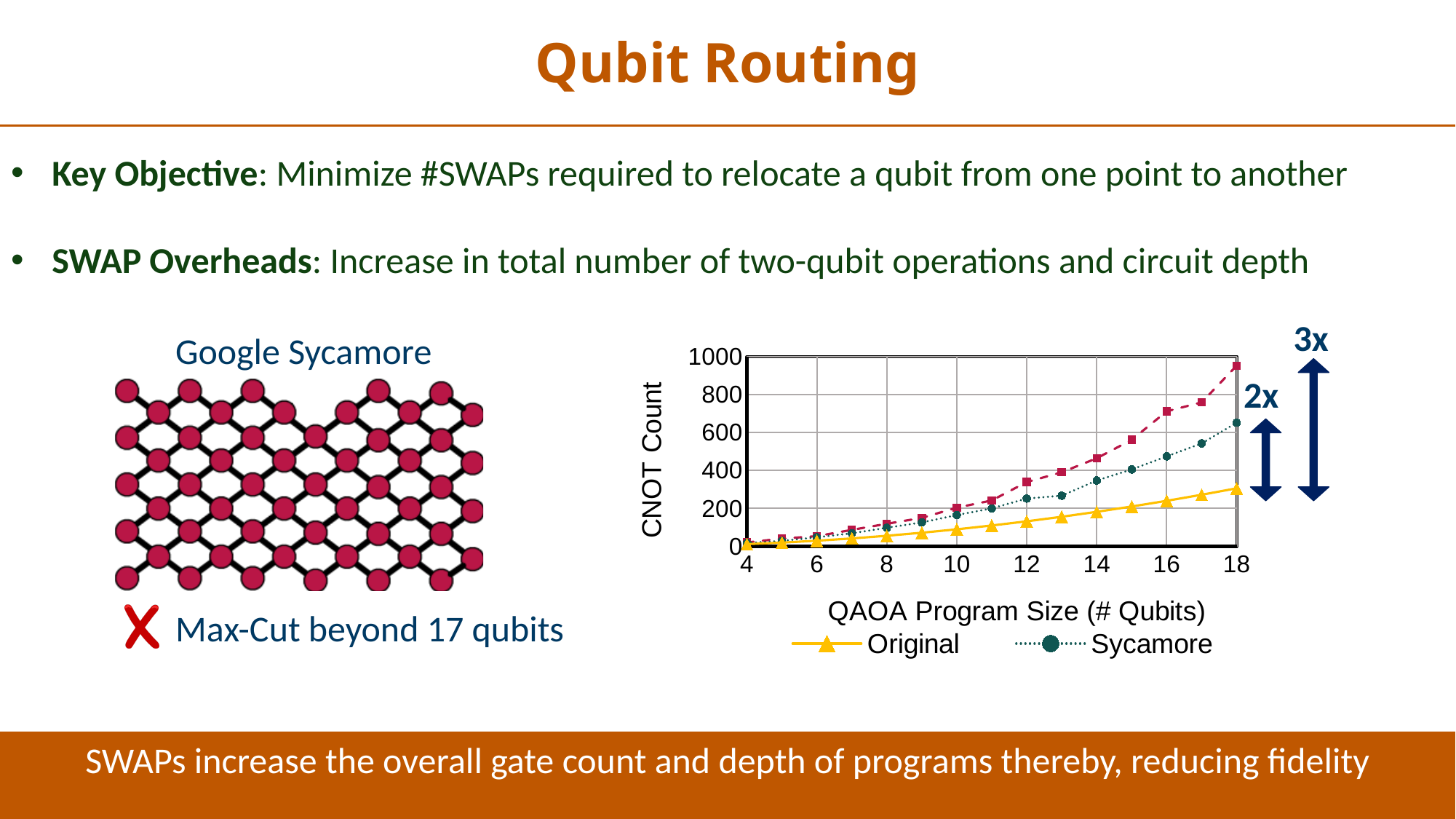
Is the CNOT count for the Original series at 18 qubits greater or less than 400? less Is the CNOT count for the Sycamore series at 18 qubits greater or less than 400? greater What is the label of the x axis of the chart? QAOA Program Size (# Qubits) How many series does the chart legend list? 2 At 18 qubits, which series has the larger CNOT count, Original or Sycamore? Sycamore Does the CNOT count for the Sycamore series rise or fall as the QAOA program size increases? rise At which QAOA program size does the Original series reach its highest CNOT count? 18 Is the CNOT count for the Sycamore series at 10 qubits greater or less than 200? less What kind of chart is shown on the right of the slide? line chart What is the label of the y axis of the chart? CNOT Count Does the CNOT count for the Original series rise or fall as the QAOA program size increases? rise